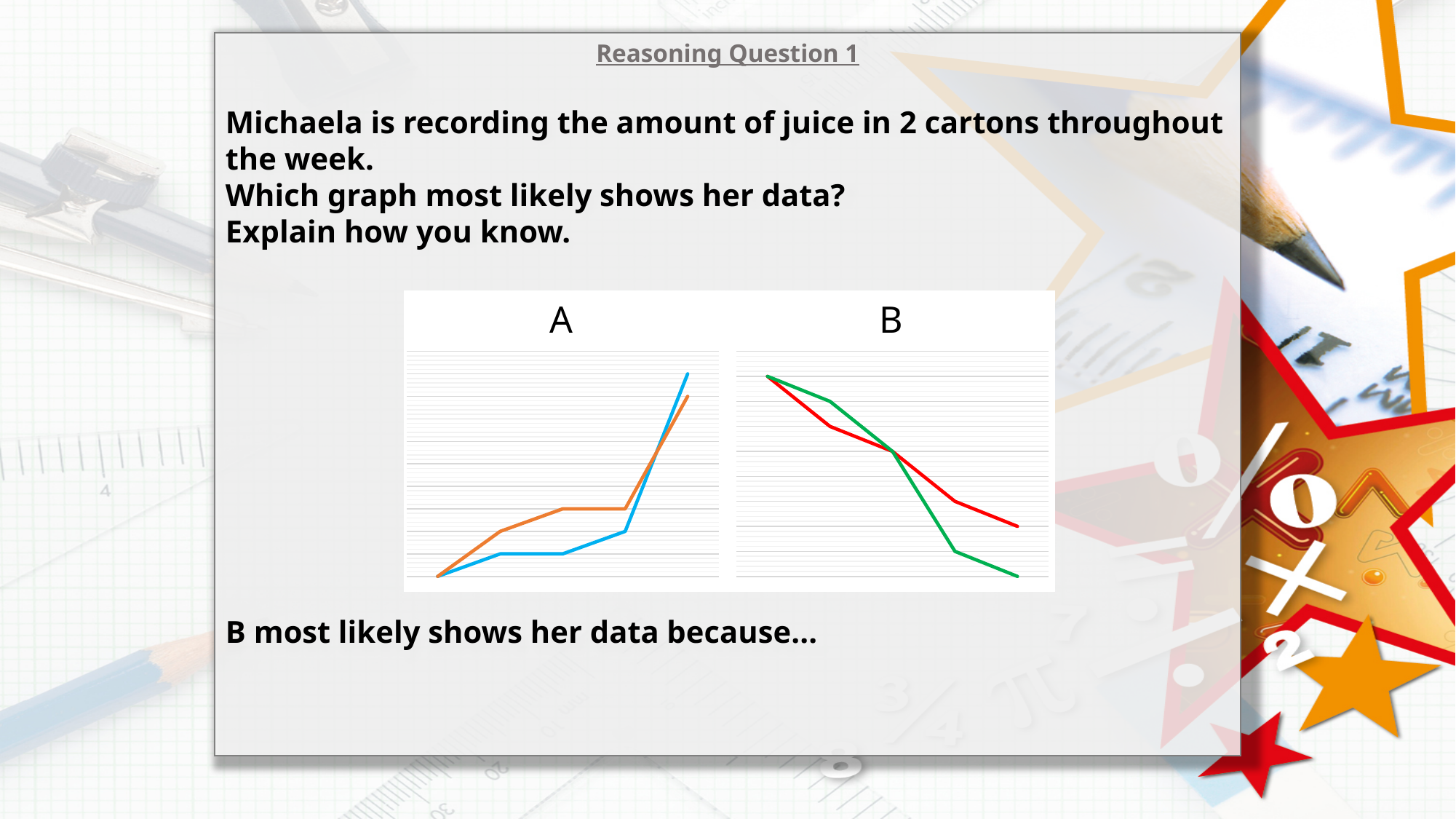
How many lines are plotted in graph B? 2 In graph B, which line ends higher at the right-hand side, the red line or the green line? red What colours are the two lines in graph A? blue and orange What kind of chart is graph A? line chart What kind of chart is graph B? line chart In graph B, do the lines rise or fall from left to right? fall In graph A, which line ends higher at the right-hand side, the blue line or the orange line? blue How many lines are plotted in graph A? 2 How many graphs are shown on the slide? 2 In graph A, at the second point from the left, which line is higher, the blue line or the orange line? orange What colours are the two lines in graph B? green and red In graph A, do the lines rise or fall from left to right? rise